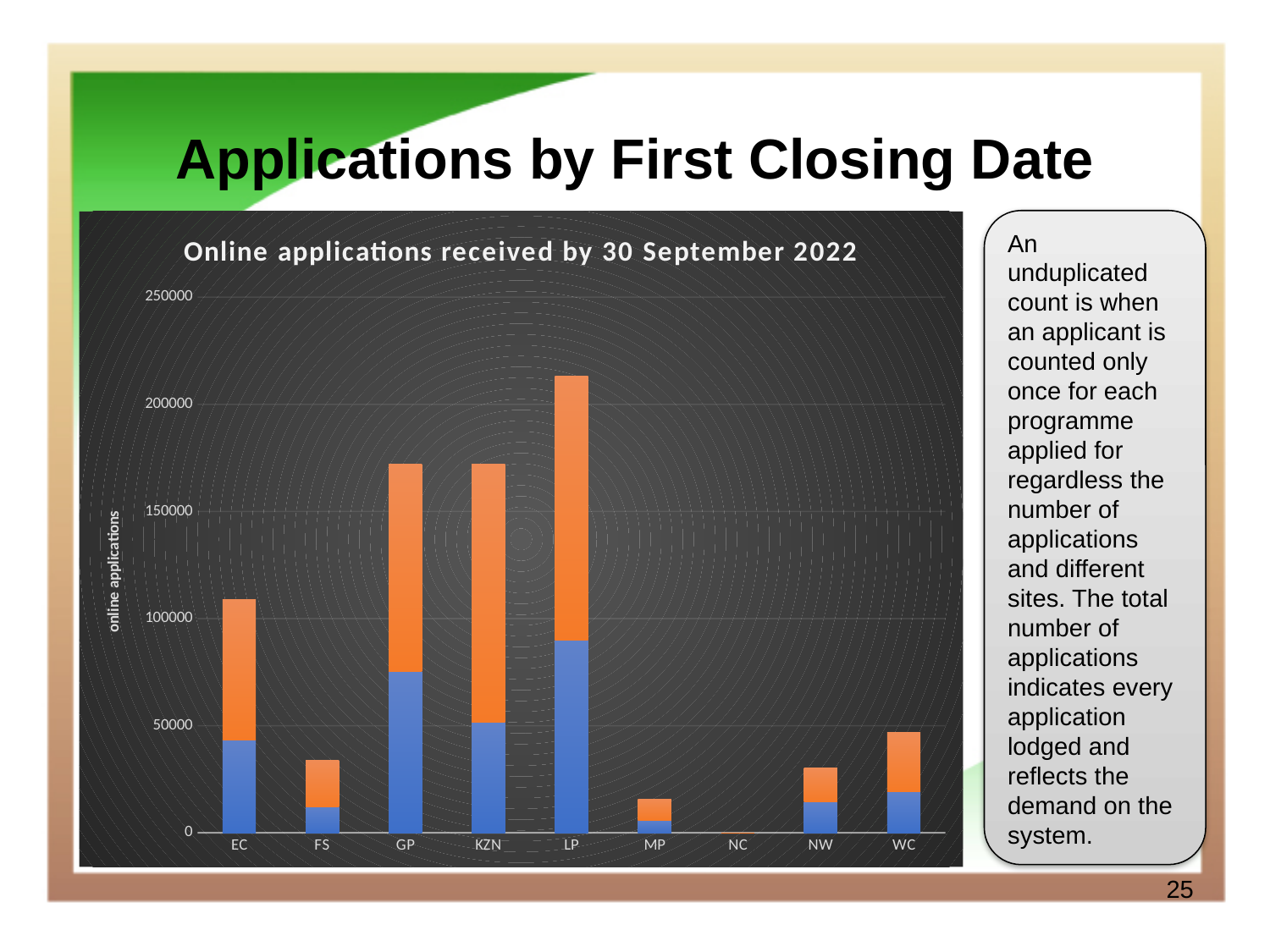
What kind of chart is shown on the slide? stacked bar chart Is the total value for FS greater or less than 50000? less Which province has the shortest bar (lowest total) in the chart? NC How many provinces (categories) are shown on the x axis of the chart? 9 Is the total value for EC greater or less than 100000? greater Which has the larger total bar, LP or GP? LP What is the label on the vertical axis of the chart? online applications Is the total value for GP greater or less than 150000? greater What is the title of the chart? Online applications received by 30 September 2022 Which province has the tallest bar (highest total) in the chart? LP